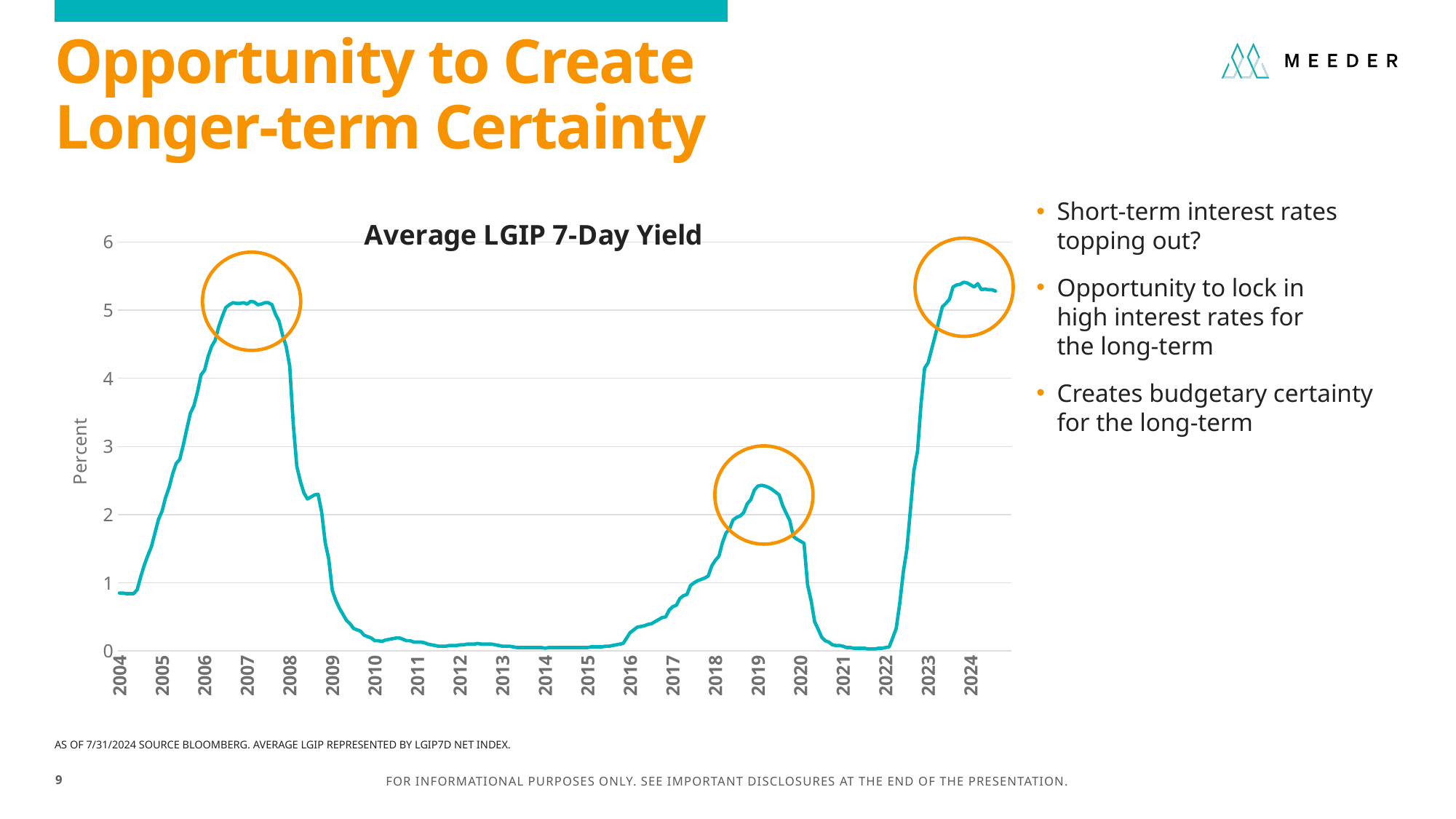
Is the value for 2024 greater or less than 5? greater Does the yield rise or fall between 2022 and 2023? Rise What is the label on the vertical axis of the chart? Percent How many years are labeled on the horizontal axis of the chart? 21 Is the peak value around 2019 greater or less than 2? greater Is the value for 2014 greater or less than 1? less Which is higher, the peak around 2007 or the peak around 2019? The peak around 2007 Does the yield rise or fall between 2008 and 2009? Fall What is the title of the chart? Average LGIP 7-Day Yield What kind of chart is shown on the slide? Line chart